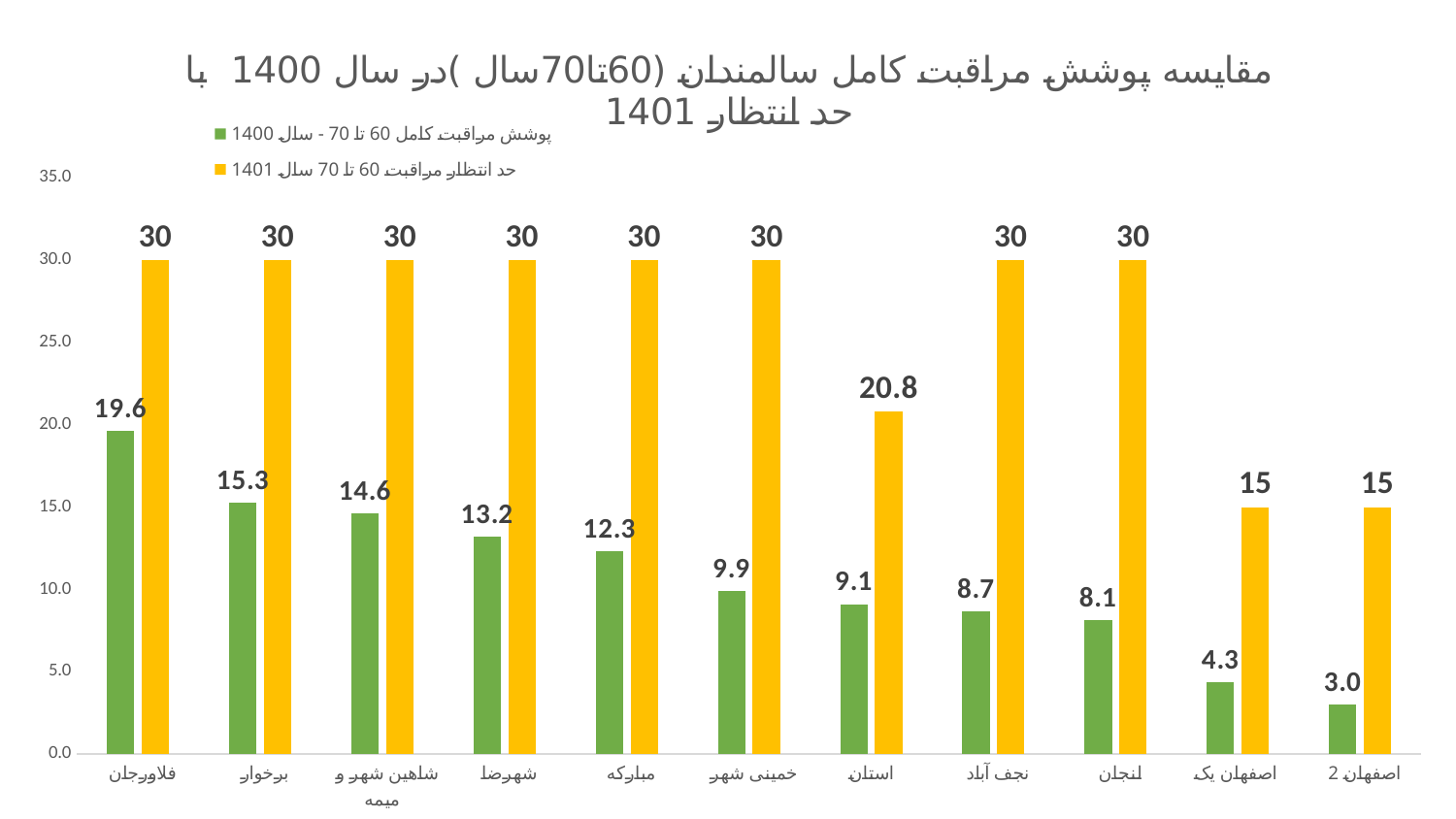
What colour are the bars for the 1401 expected level series? yellow What is the value of the 1401 expected level (yellow) series for استان? 20.8 Which category has the lowest value in the 1400 coverage (green) series? اصفهان 2 What is the value of the 1400 coverage (green) series for اصفهان 2? 3.0 How many categories are shown on the x axis? 11 How many series does the legend list? 2 Which category has the highest value in the 1400 coverage (green) series? فلاورجان Do the values of the 1400 coverage (green) series rise or fall from left to right along the x axis? fall Which is larger for برخوار: the 1400 coverage value or the 1401 expected level? the 1401 expected level What is the value of the 1400 coverage (green) series for فلاورجان? 19.6 What is the difference between the 1401 expected level and the 1400 coverage for لنجان? 21.9 What type of chart is shown on the slide? bar chart